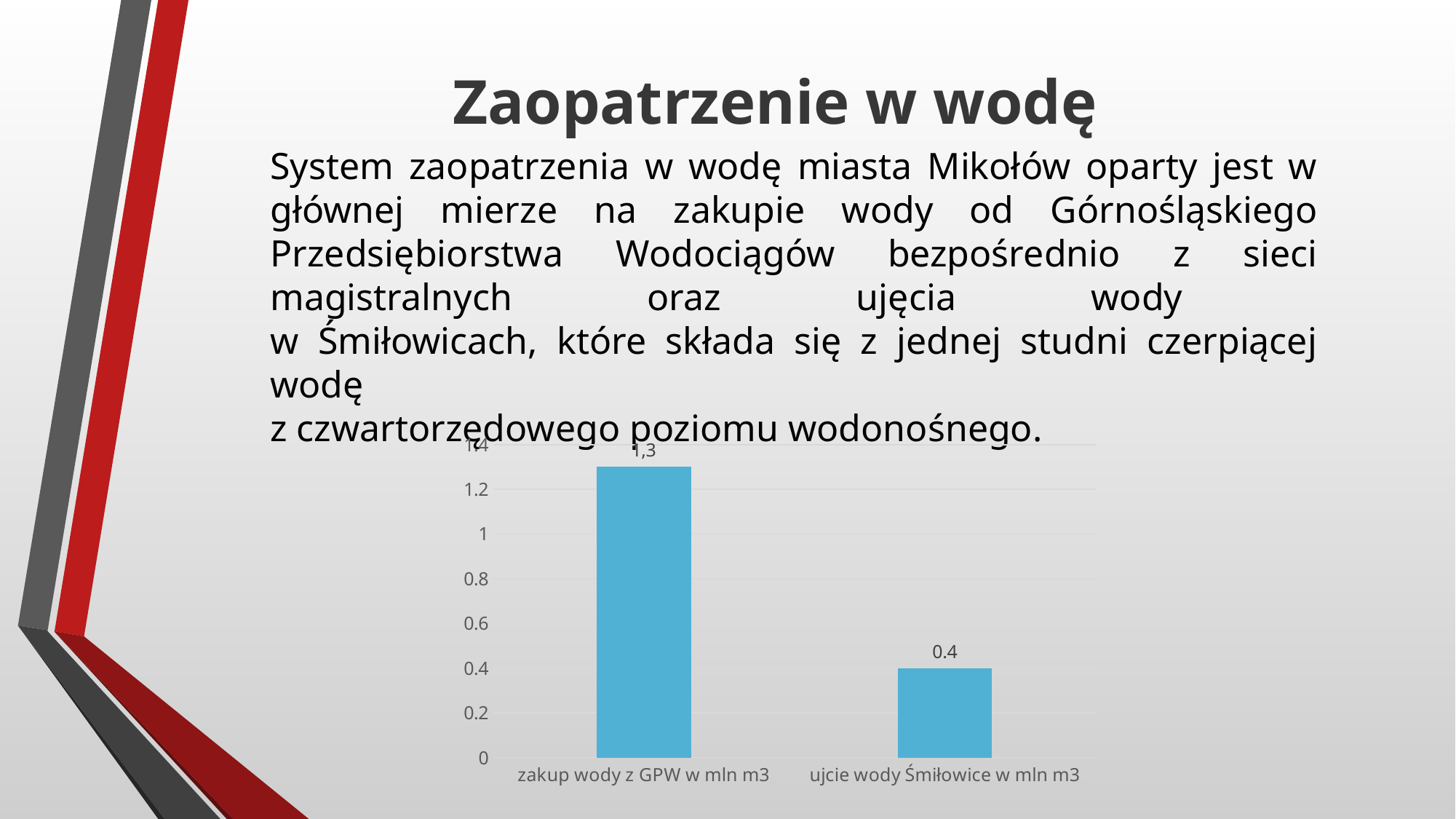
What is the difference between the values for 'zakup wody z GPW w mln m3' and 'ujcie wody Śmiłowice w mln m3'? 0.9 How many bars (categories) does the chart show? 2 Which category has the highest value? zakup wody z GPW w mln m3 What is the maximum value shown on the vertical axis of the chart? 1.4 Is the value for 'zakup wody z GPW w mln m3' greater or less than 1? greater What colour are the bars in the chart? blue Which category has the lowest value? ujcie wody Śmiłowice w mln m3 What is the value for 'ujcie wody Śmiłowice w mln m3'? 0.4 Which is larger: the value for 'zakup wody z GPW w mln m3' or for 'ujcie wody Śmiłowice w mln m3'? zakup wody z GPW w mln m3 What is the value for 'zakup wody z GPW w mln m3'? 1,3 What type of chart is shown on the slide? bar chart Is the value for 'ujcie wody Śmiłowice w mln m3' greater or less than 0.6? less